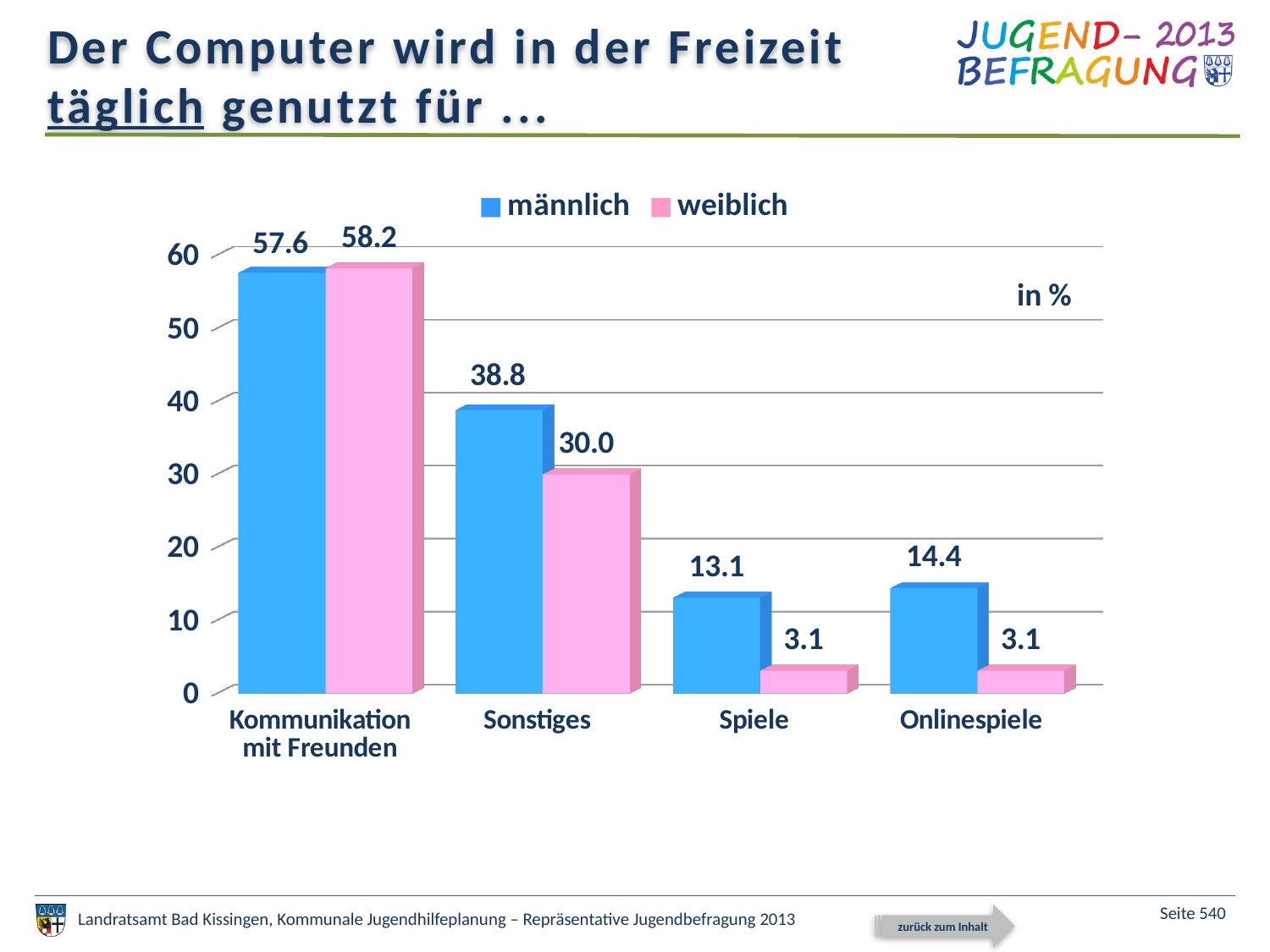
Which colour represents the weiblich series? pink Which category has the lowest value for männlich? Spiele Which is larger in the Spiele category, the männlich value or the weiblich value? männlich How many categories are shown on the x axis? 4 What is the value for männlich in the Onlinespiele category? 14.4 What is the value for männlich in the Kommunikation mit Freunden category? 57.6 What kind of chart is shown on the slide? bar chart What is the value for weiblich in the Sonstiges category? 30.0 How many series does the legend list? 2 Which category has the highest value for weiblich? Kommunikation mit Freunden What is the difference between the männlich and weiblich values in the Sonstiges category? 8.8 What is the difference between the männlich and weiblich values in the Onlinespiele category? 11.3